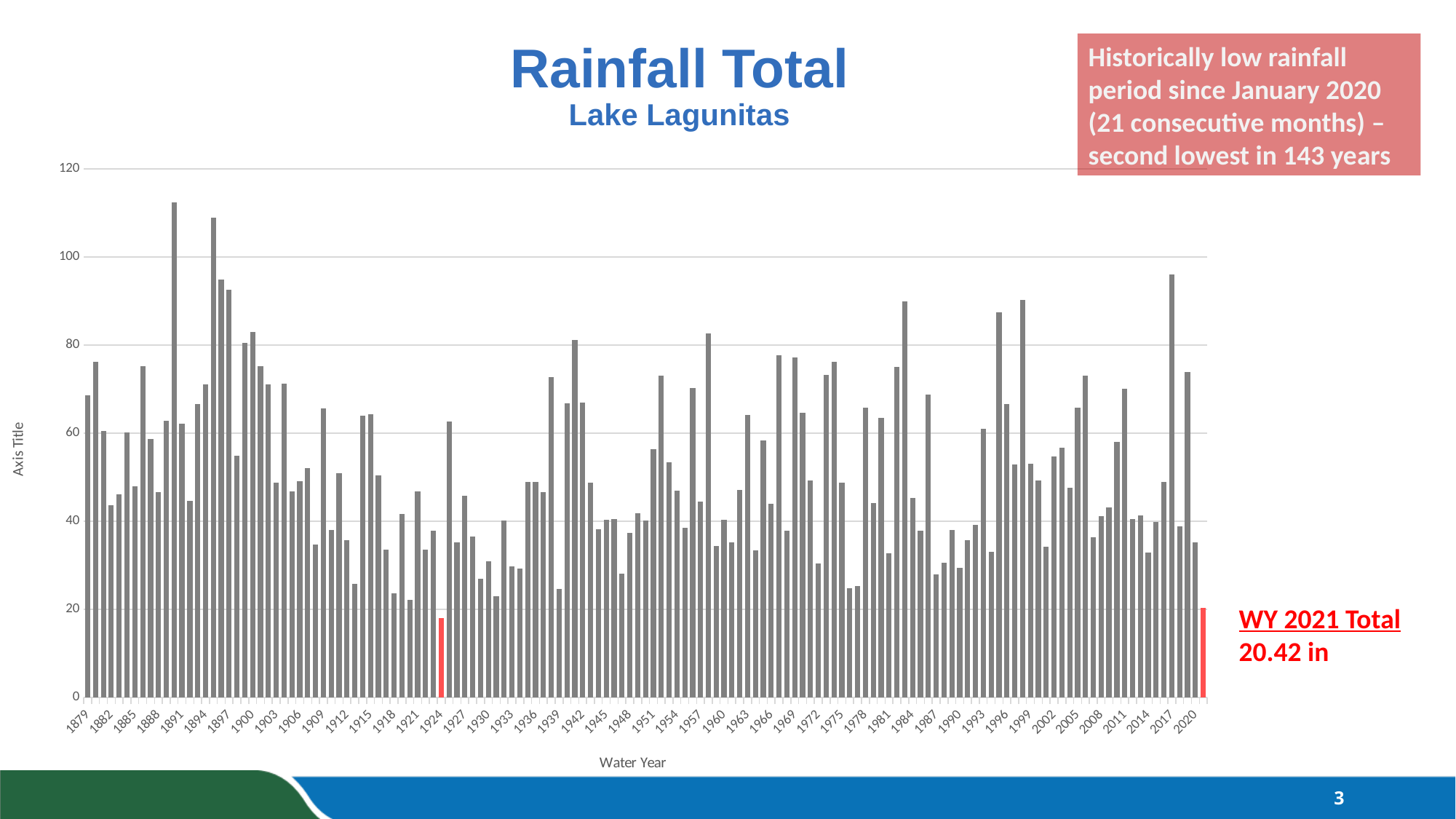
Which water year has the lowest rainfall total in the chart? 1924 Is the rainfall total for 1891 greater or less than 100? less Is the rainfall total for 2017 greater or less than 80? greater Which water year has the highest rainfall total in the chart? 1890 Which water year has the larger rainfall total, 1891 or 2017? 2017 What is the WY 2021 rainfall total shown on the slide? 20.42 in Which water year has the larger rainfall total, 1879 or 2020? 1879 What kind of chart is shown on the slide? bar chart What is the title of the x axis of the chart? Water Year Is the rainfall total for 2020 greater or less than 40? less What colour are the highlighted bars for the lowest rainfall years in the chart? red